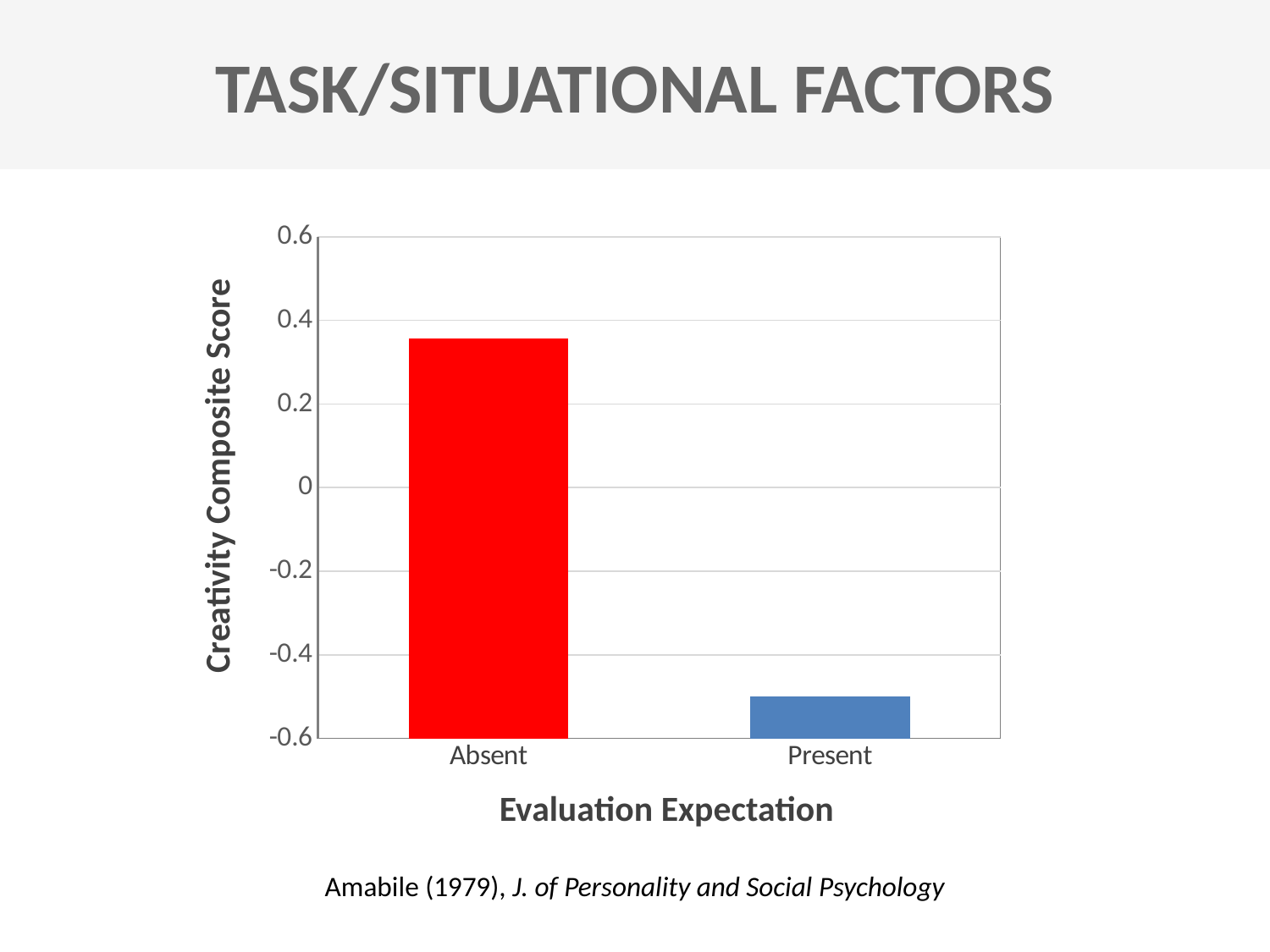
What is the title of the y axis? Creativity Composite Score Which category has the lowest Creativity Composite Score? Present What is the title of the x axis? Evaluation Expectation What kind of chart is shown on the slide? bar chart How many categories are shown on the x axis? 2 Is the value for Absent greater or less than 0.4? less Which has the larger Creativity Composite Score, Absent or Present? Absent Is the value for Absent greater or less than 0.2? greater Is the value for Present greater or less than -0.4? less Which category has the highest Creativity Composite Score? Absent